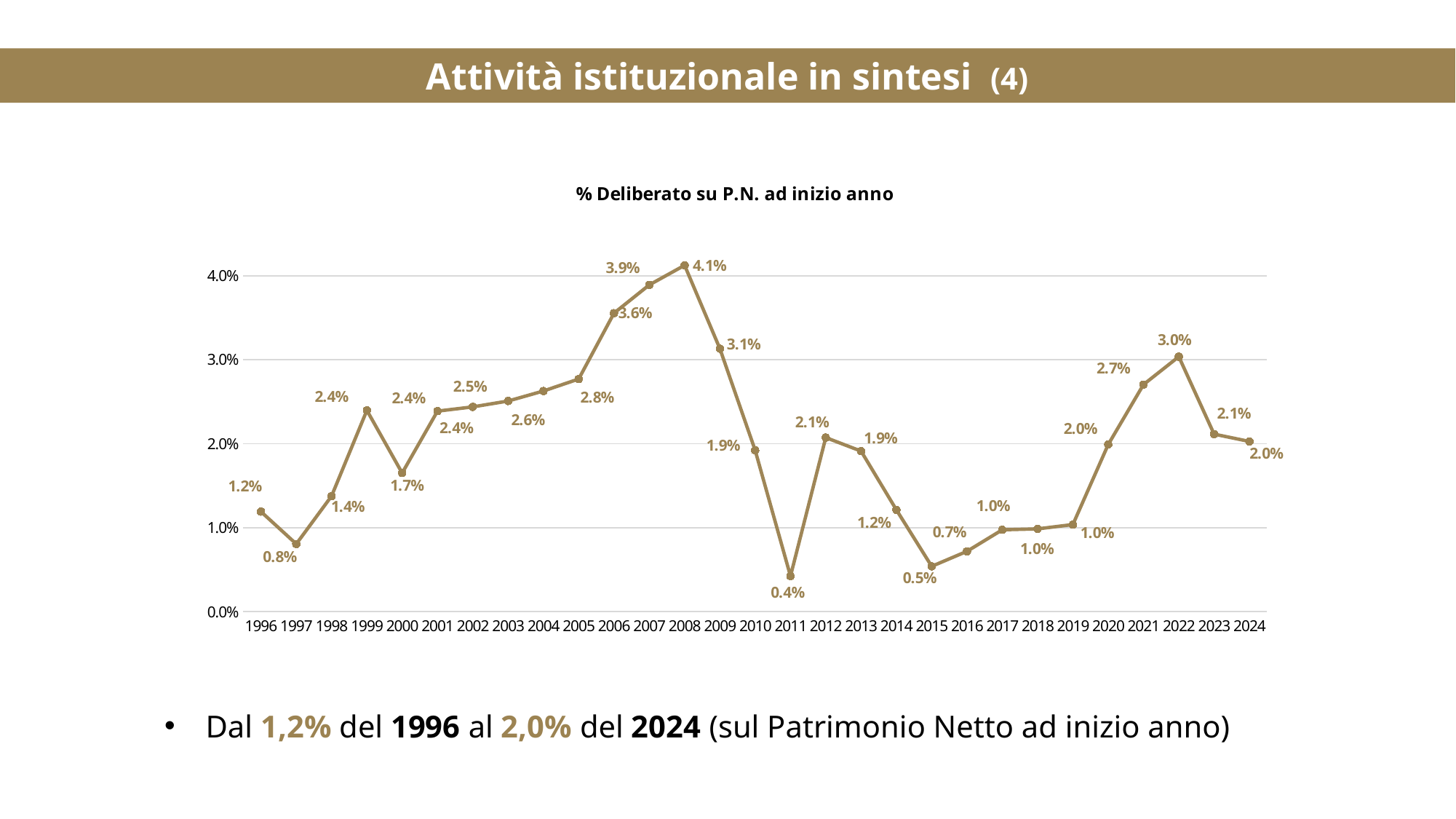
What is the value for 2024 in the chart? 2.0% How many years are plotted on the x axis of the chart? 29 Which year has the lowest value in the chart? 2011 What kind of chart is shown on the slide? line chart What is the value for 2008 in the chart? 4.1% Which year has the highest value in the chart? 2008 Which year has the larger value, 2021 or 2022? 2022 What is the title of the chart? % Deliberato su P.N. ad inizio anno What is the value for 2011 in the chart? 0.4% What is the difference between the value for 2008 and the value for 2011? 3.7 percentage points Is the value for 2006 greater or less than 3.0%? greater Do the values rise or fall from 2008 to 2011? fall